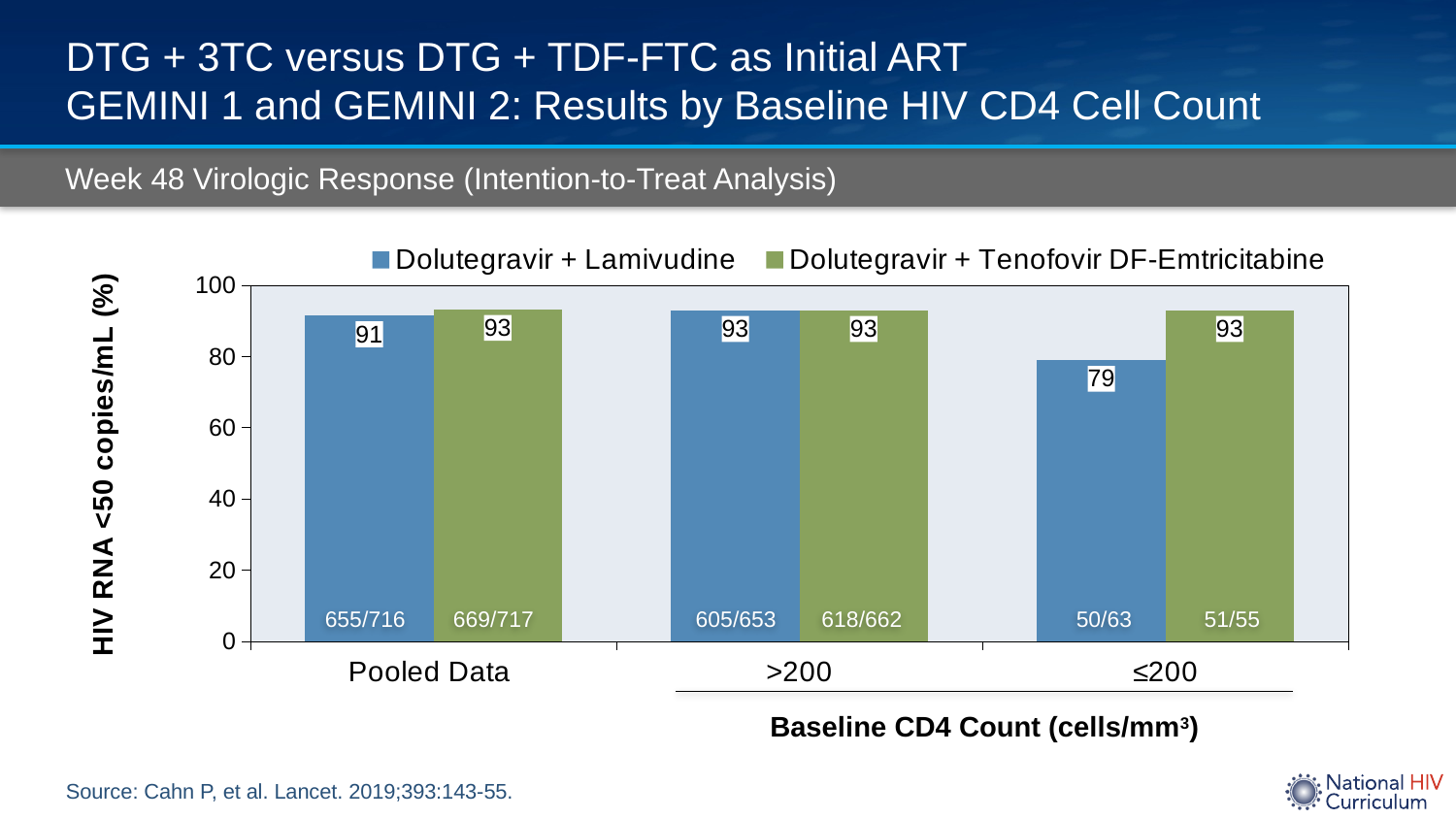
What is the value for Dolutegravir + Tenofovir DF-Emtricitabine in the >200 category? 93 What is the value for Dolutegravir + Lamivudine in the Pooled Data category? 91 What is the value for Dolutegravir + Tenofovir DF-Emtricitabine in the ≤200 category? 93 What is the difference between the two series in the Pooled Data category? 2 How many series does the legend list? 2 In the ≤200 category, which series has the larger value? Dolutegravir + Tenofovir DF-Emtricitabine What is the difference between the Dolutegravir + Tenofovir DF-Emtricitabine and Dolutegravir + Lamivudine values in the ≤200 category? 14 What is the value for Dolutegravir + Lamivudine in the ≤200 category? 79 How many categories are shown on the x axis? 3 What kind of chart is shown on the slide? bar chart Is the value for Dolutegravir + Lamivudine in the ≤200 category greater or less than 80? less In which category is the Dolutegravir + Lamivudine value lowest? ≤200